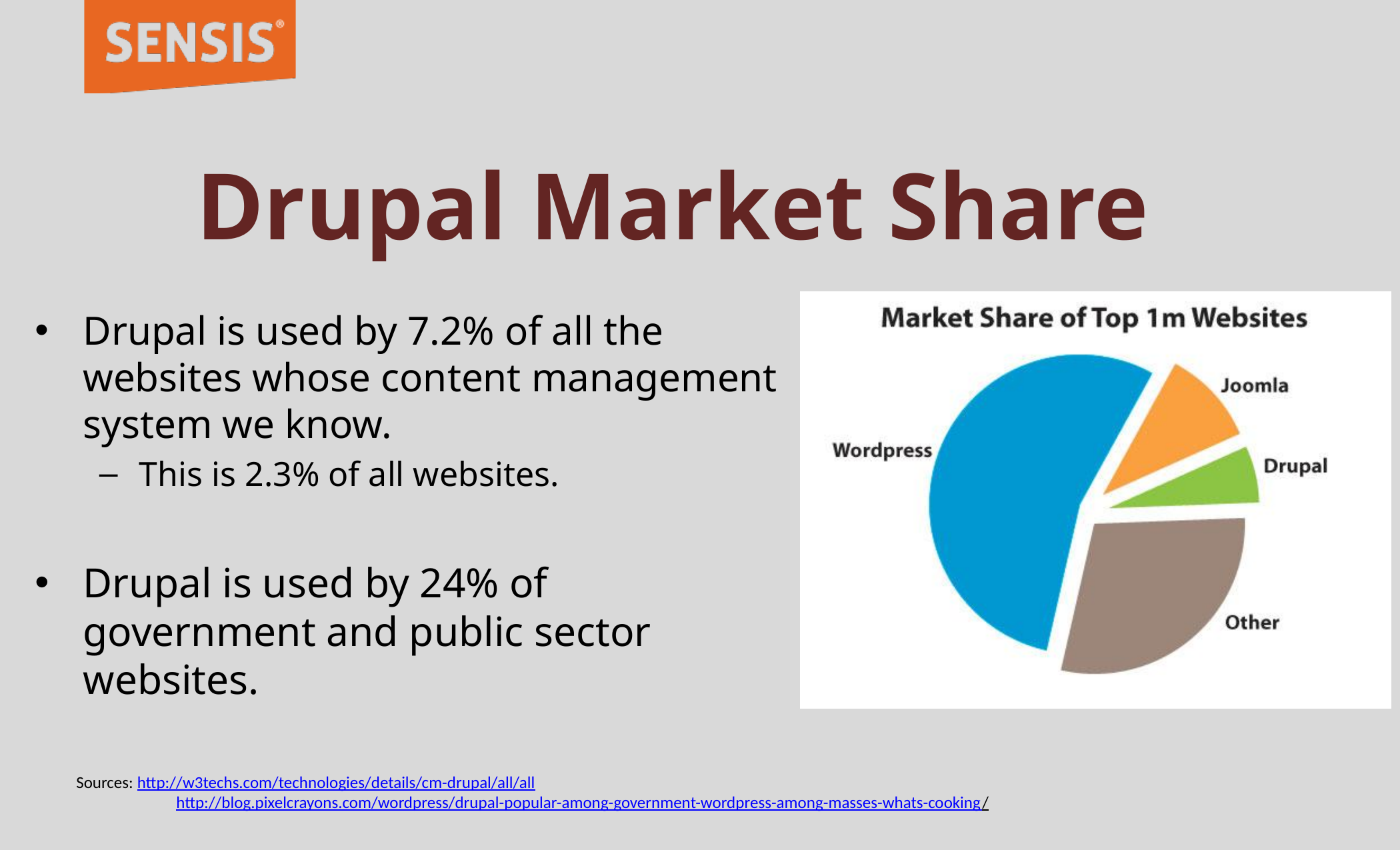
Which category has the smallest slice in the pie chart? Drupal Which slice is larger in the pie chart, Wordpress or Other? Wordpress What kind of chart is shown on the slide? Pie chart Which category has the largest slice in the pie chart? Wordpress Which slice is larger in the pie chart, Joomla or Drupal? Joomla What is the title of the pie chart? Market Share of Top 1m Websites Which category has the second-largest slice in the pie chart? Other Which slice is larger in the pie chart, Other or Joomla? Other How many slices does the pie chart have? 4 What colour is the Drupal slice in the pie chart? Green